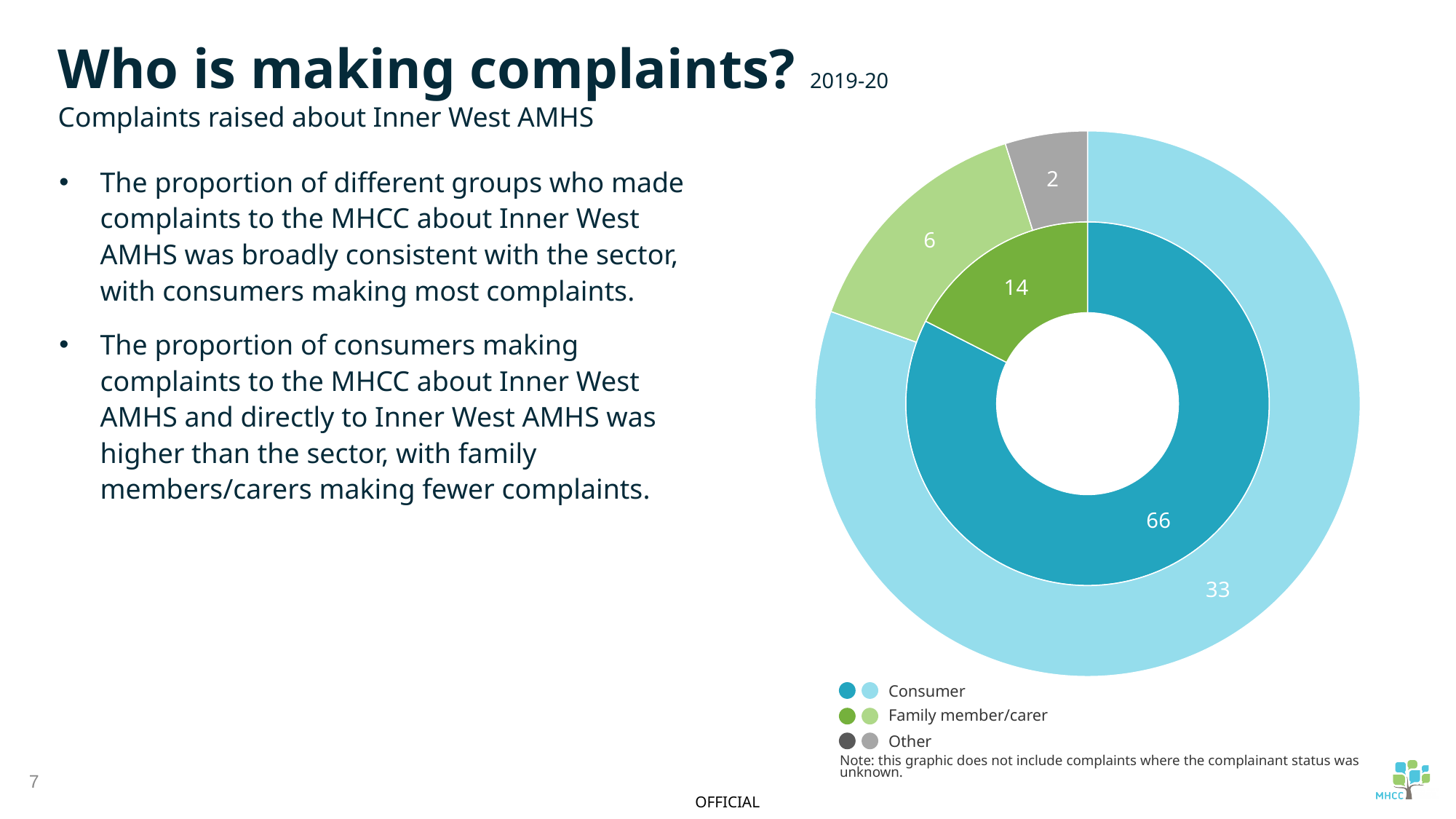
Which group has the smallest segment in the outer ring of the doughnut chart? Other What is the total of the values shown in the outer ring of the doughnut chart? 41 What is the title of the slide containing the chart? Who is making complaints? How many entries does the chart legend list? 3 What is the value for Consumer in the inner ring of the doughnut chart? 66 What is the value for Family member/carer in the outer ring of the doughnut chart? 6 What is the value for Family member/carer in the inner ring of the doughnut chart? 14 What kind of chart is shown on the slide? Doughnut chart What is the value for Other in the outer ring of the doughnut chart? 2 In the inner ring, what is the difference between the Consumer value and the Family member/carer value? 52 Which group has the largest segment in the outer ring of the doughnut chart? Consumer What is the value for Consumer in the outer ring of the doughnut chart? 33